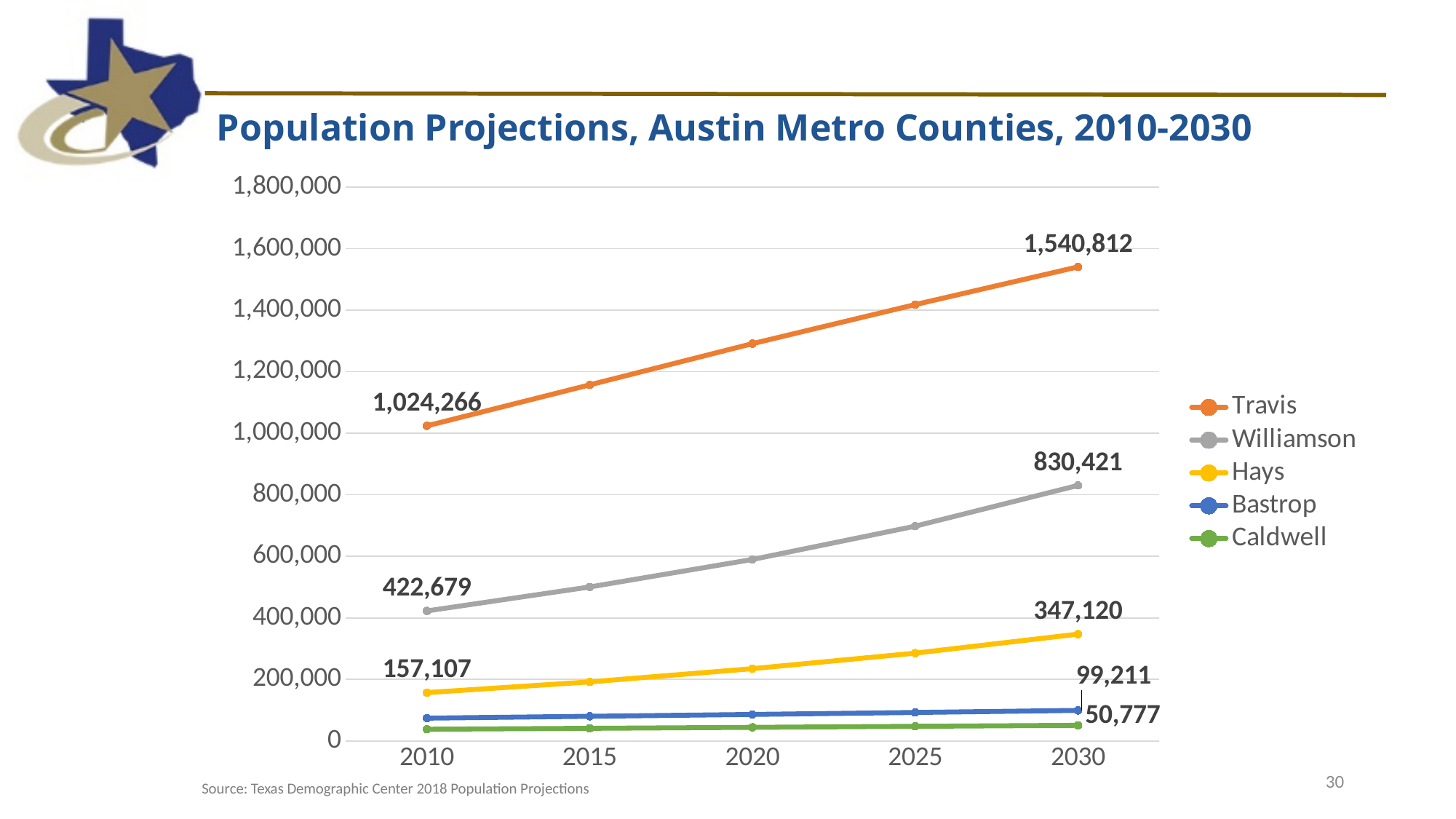
By how much is Travis County's population projected to grow from 2010 to 2030? 516,546 What is the projected population of Bastrop County in 2030? 99,211 Is the Travis County population in 2020 greater or less than 1,200,000? greater What is the projected population of Hays County in 2030? 347,120 Which county has the lowest projected population in 2030? Caldwell How many series does the legend list? 5 What is the difference between the 2030 projected populations of Williamson and Hays counties? 483,301 What is the projected population of Caldwell County in 2030? 50,777 What is the projected population of Travis County in 2030? 1,540,812 Which county has the highest projected population in 2030? Travis What is the population of Williamson County in 2010? 422,679 What kind of chart is shown on the slide? Line chart